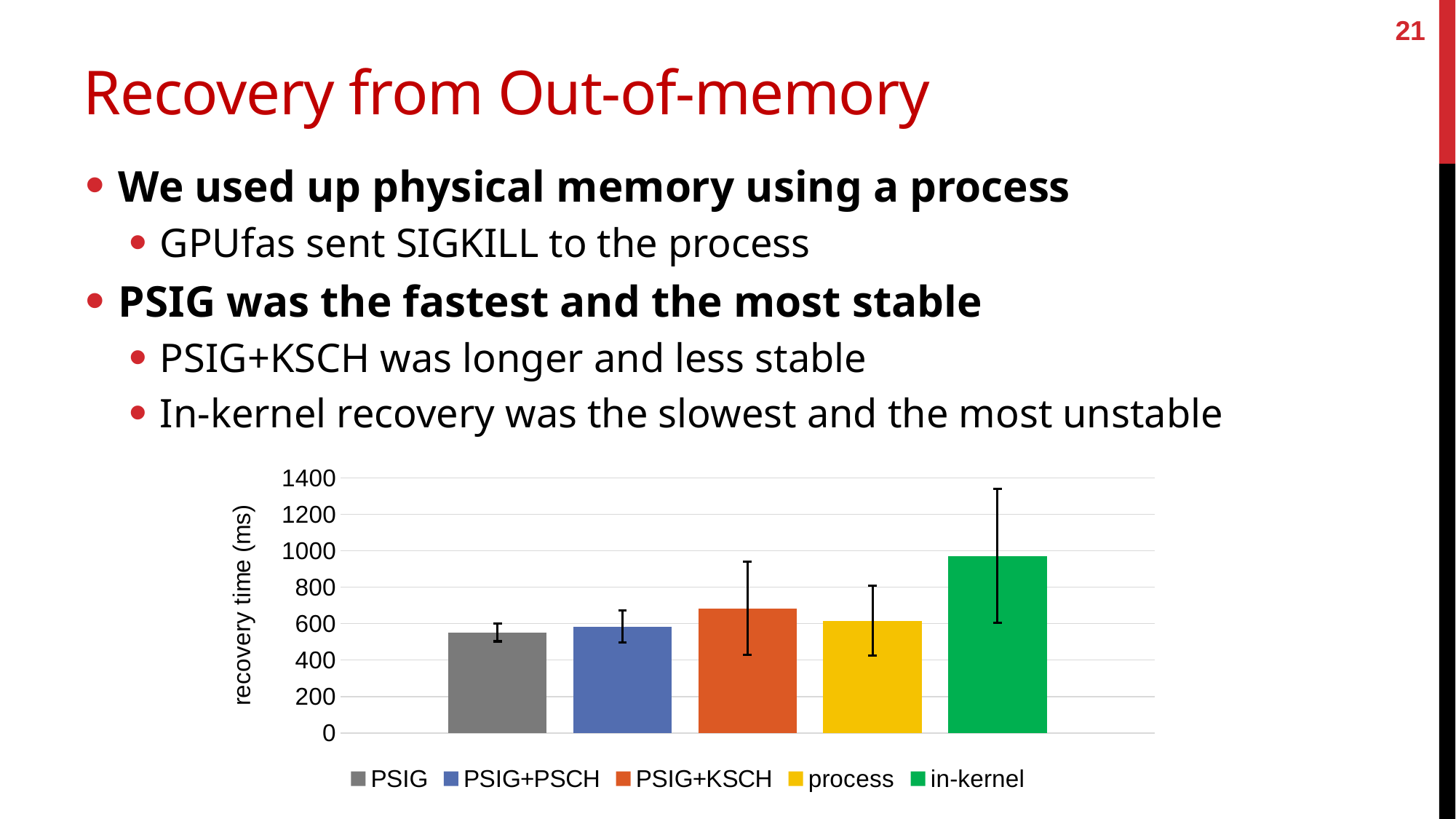
Which category has the highest recovery time in the chart? in-kernel How many entries does the chart legend list? 5 Is the recovery time for in-kernel greater or less than 800? greater Which has the larger recovery time, in-kernel or PSIG? in-kernel Is the recovery time for process greater or less than 800? less What kind of chart is shown on the slide? bar chart How many bars are plotted in the chart? 5 Is the recovery time for PSIG+PSCH greater or less than 800? less What is the label on the vertical axis of the chart? recovery time (ms) Which has the larger recovery time, PSIG+KSCH or PSIG? PSIG+KSCH